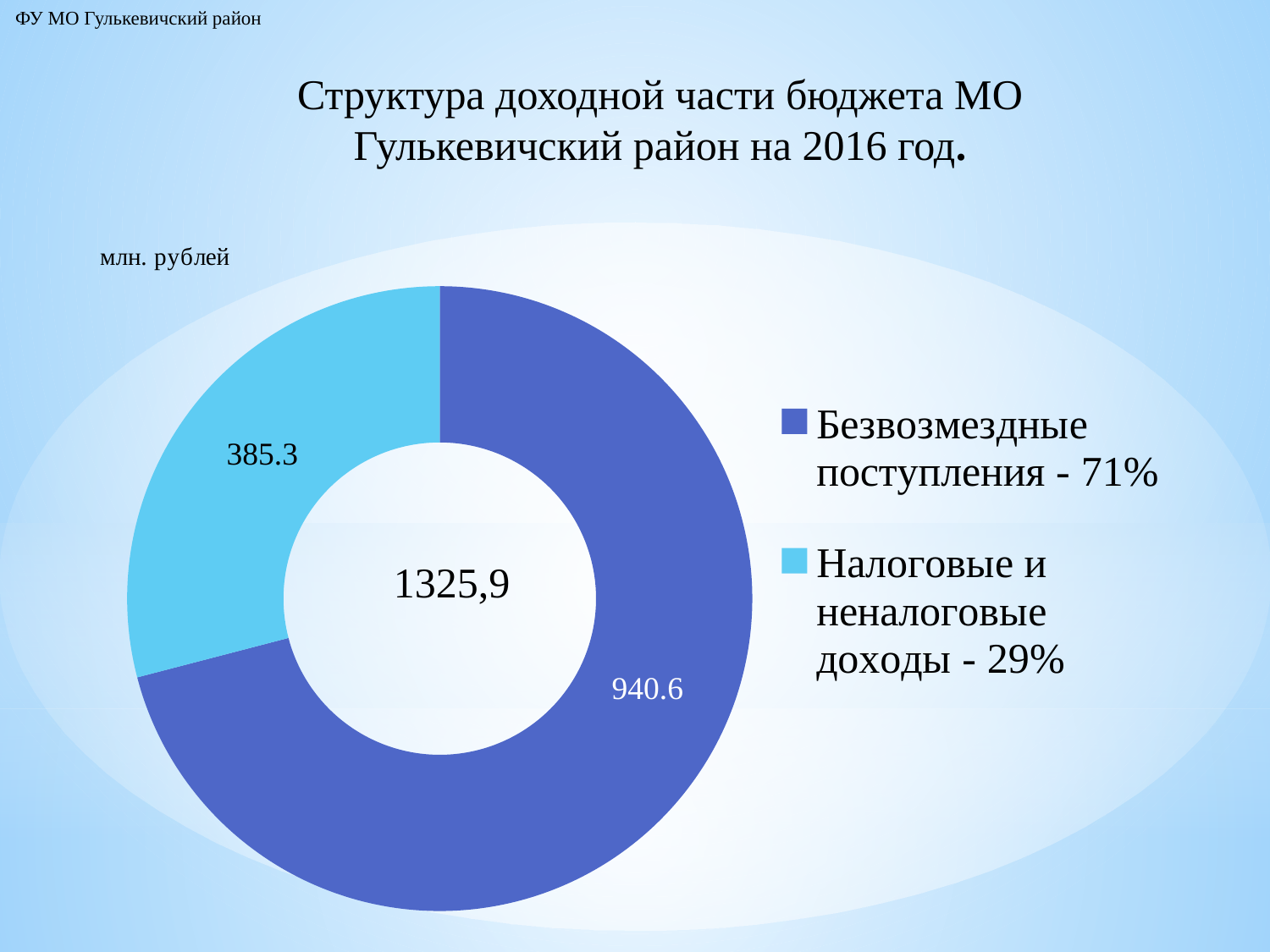
What is the difference between the values for Безвозмездные поступления and Налоговые и неналоговые доходы? 555.3 What kind of chart is shown on the slide? Doughnut chart What is the value for Налоговые и неналоговые доходы? 385.3 Which category has the smallest slice? Налоговые и неналоговые доходы In what units are the chart values given? млн. рублей Which is larger: Безвозмездные поступления or Налоговые и неналоговые доходы? Безвозмездные поступления What share of the total do Безвозмездные поступления make up? 71% What is the value for Безвозмездные поступления? 940.6 How many categories does the chart show? 2 Which category has the largest slice? Безвозмездные поступления What is the total value shown in the centre of the chart? 1325,9 What share of the total do Налоговые и неналоговые доходы make up? 29%